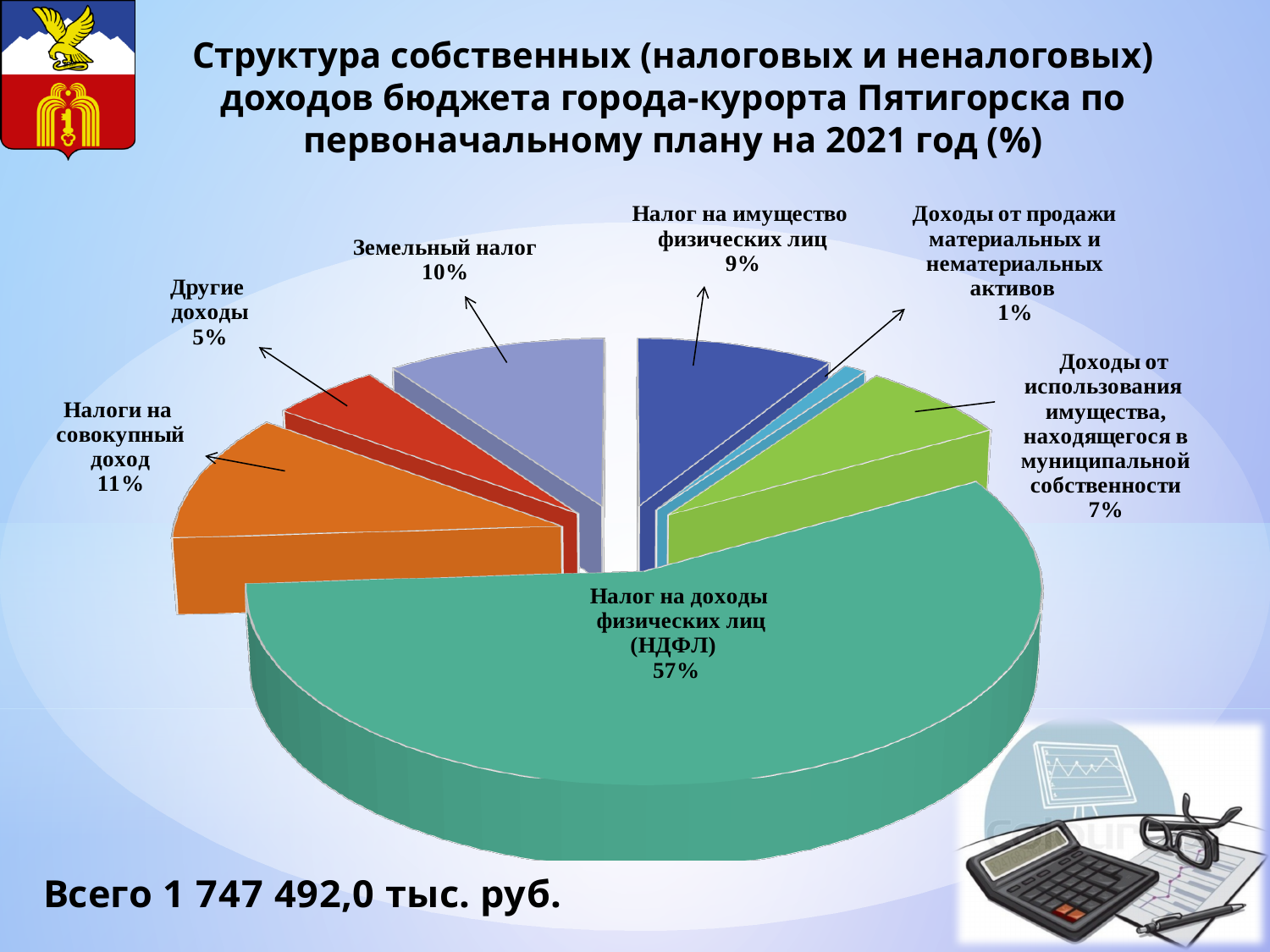
What percentage is shown for "Налоги на совокупный доход"? 11% What kind of chart is shown on the slide? pie chart Which category has the largest share of the pie? Налог на доходы физических лиц (НДФЛ) Which category has the smallest share of the pie? Доходы от продажи материальных и нематериальных активов What share of the budget's own revenues does "Налог на доходы физических лиц (НДФЛ)" account for? 57% What total amount of own revenues is stated below the chart? 1 747 492,0 тыс. руб. What is the difference in percentage points between "Налоги на совокупный доход" and "Другие доходы"? 6 What percentage is shown for "Земельный налог"? 10% Which is larger: the share for "Земельный налог" or the share for "Налог на имущество физических лиц"? Земельный налог What percentage is shown for "Доходы от использования имущества, находящегося в муниципальной собственности"? 7% How many categories (slices) does the pie chart have? 7 What percentage is shown for "Доходы от продажи материальных и нематериальных активов"? 1%